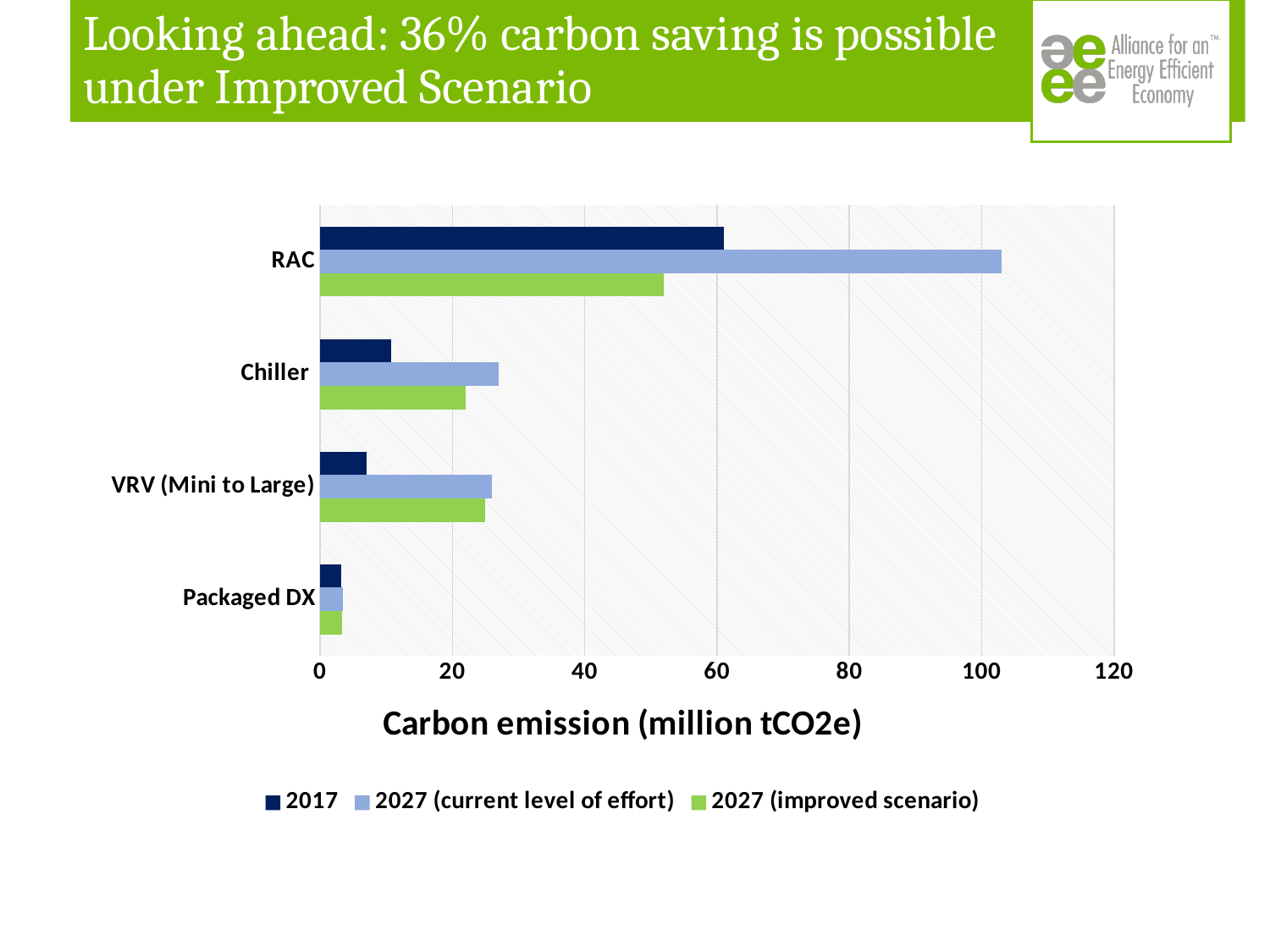
Which is larger, the 2017 value for RAC or the 2017 value for Chiller? RAC How many series does the legend list? 3 Is the 2027 (current level of effort) value for Chiller greater or less than 20? greater Which is larger, the 2017 value for Chiller or the 2017 value for VRV (Mini to Large)? Chiller Is the 2027 (current level of effort) value for RAC greater or less than 80? greater What kind of chart is shown on the slide? Bar chart Is the 2017 value for VRV (Mini to Large) greater or less than 20? less How many categories are shown on the chart? 4 Which category has the highest value for the 2027 (current level of effort) series? RAC Which category has the lowest value for the 2017 series? Packaged DX What is the title of the horizontal axis? Carbon emission (million tCO2e)